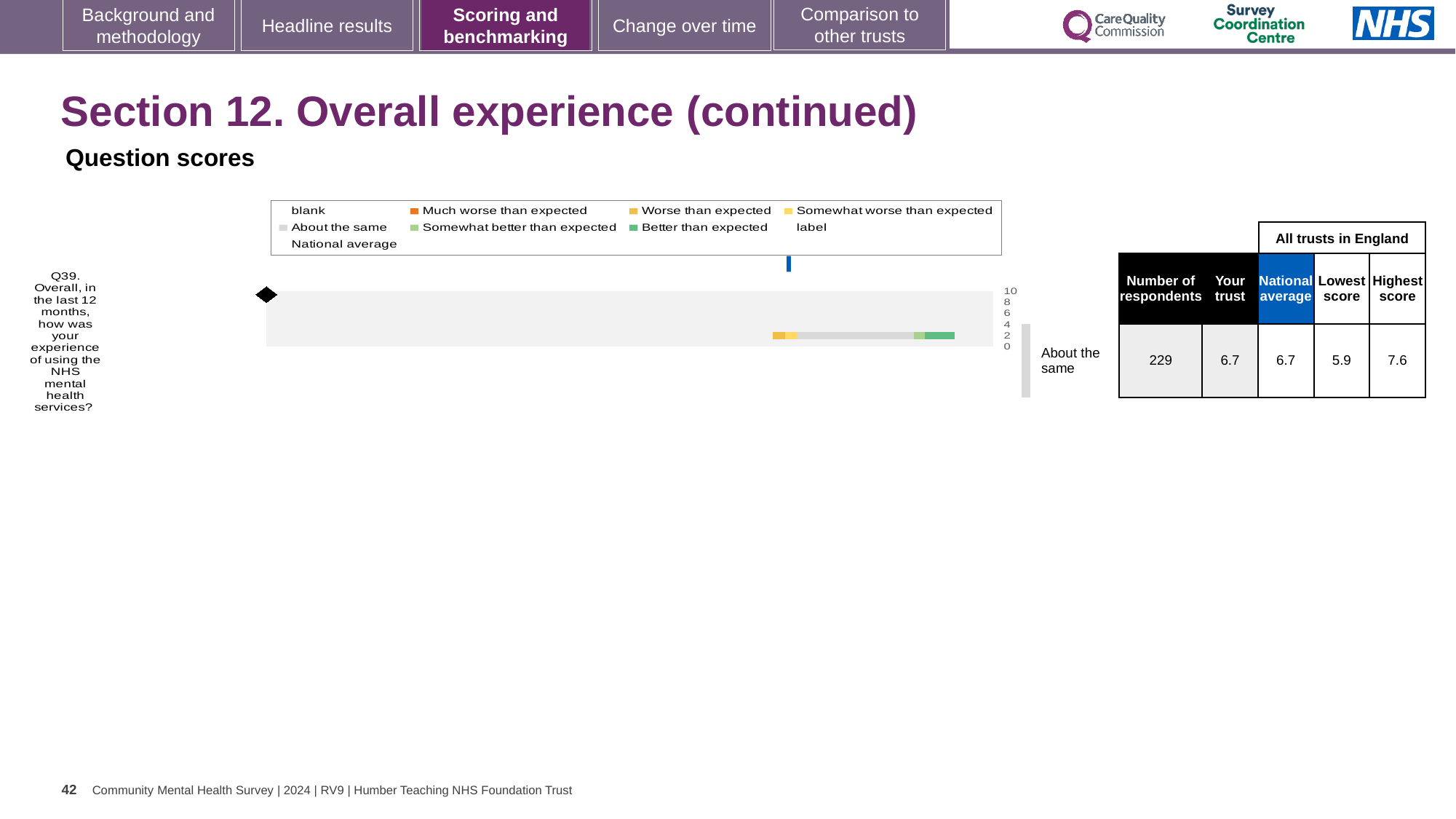
What is the difference between the highest score and the lowest score for Q39? 1.7 What is the lowest score among all trusts in England for Q39? 5.9 Is the 'Your trust' score for Q39 greater or less than 6 on the axis? greater What is the highest score among all trusts in England for Q39? 7.6 How many survey questions are plotted in the chart? 1 What is the 'Your trust' score for Q39? 6.7 Which question is plotted in the chart? Q39. Overall, in the last 12 months, how was your experience of using the NHS mental health services? How many respondents answered Q39? 229 What is the national average score for Q39? 6.7 What kind of chart is shown on the slide? bar chart What benchmarking category is shown for Q39? About the same How many entries does the chart legend list? 9